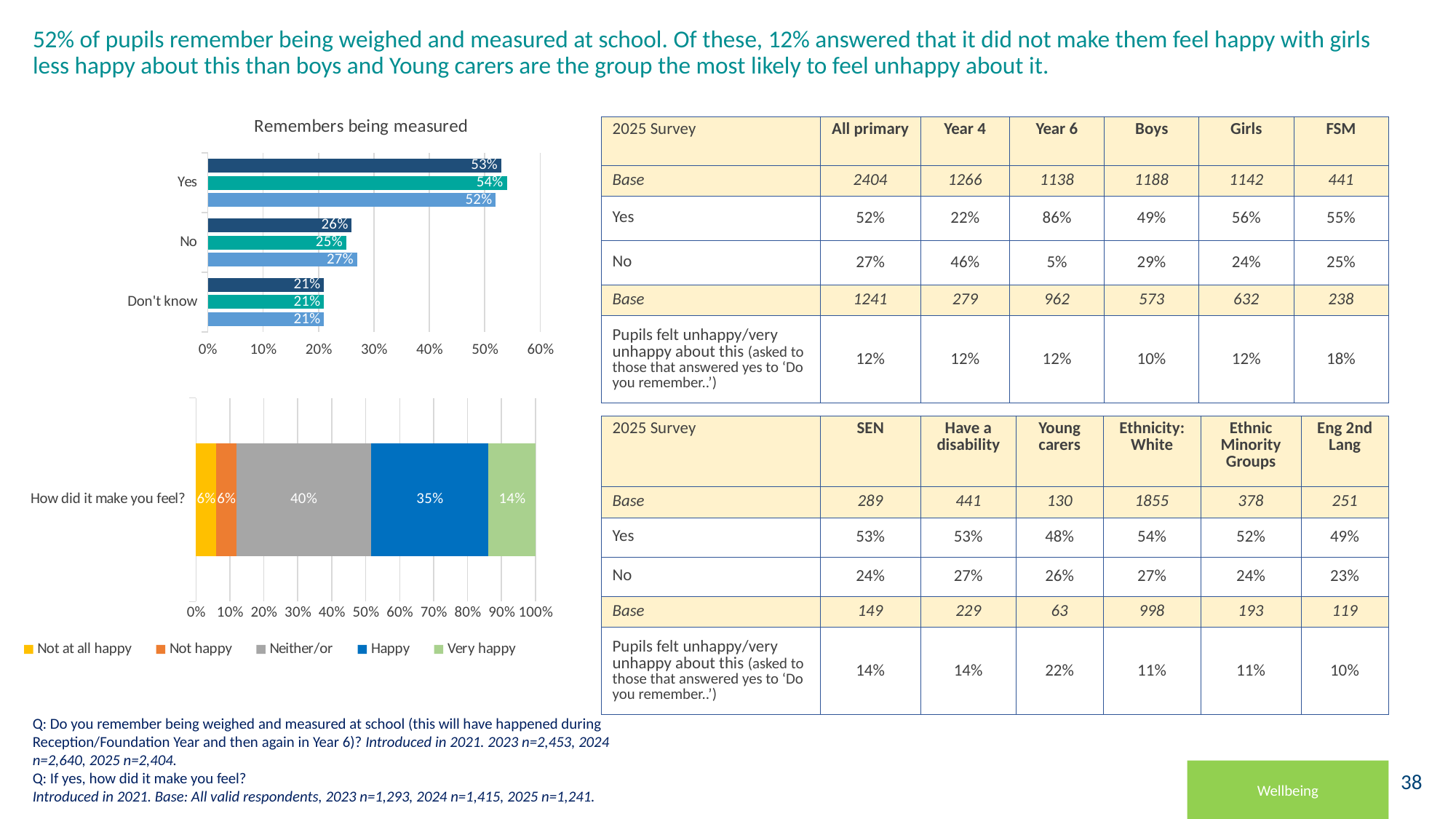
On the 'How did it make you feel?' chart, which response has the largest share? Neither/or On the 'Remembers being measured' chart, is the dark blue (top) bar for 'No' greater or less than 30%? less How many series does the legend of the 'How did it make you feel?' chart list? 5 On the 'Remembers being measured' chart, what is the difference between the teal bar for 'Yes' and the teal bar for 'No'? 29 percentage points On the 'Remembers being measured' chart, which response category has the highest values? Yes On the 'How did it make you feel?' chart, what percentage answered 'Neither/or'? 40% On the 'Remembers being measured' chart, what is the value of the light blue (bottom) bar for 'No'? 27% On the 'Remembers being measured' chart, what value do all three bars for 'Don't know' show? 21% How many response categories are shown on the 'Remembers being measured' chart? 3 On the 'Remembers being measured' chart, what is the value of the teal (middle) bar for 'Yes'? 54% What type of chart is the 'Remembers being measured' chart? bar chart On the 'How did it make you feel?' chart, what is the difference between 'Happy' and 'Very happy'? 21 percentage points